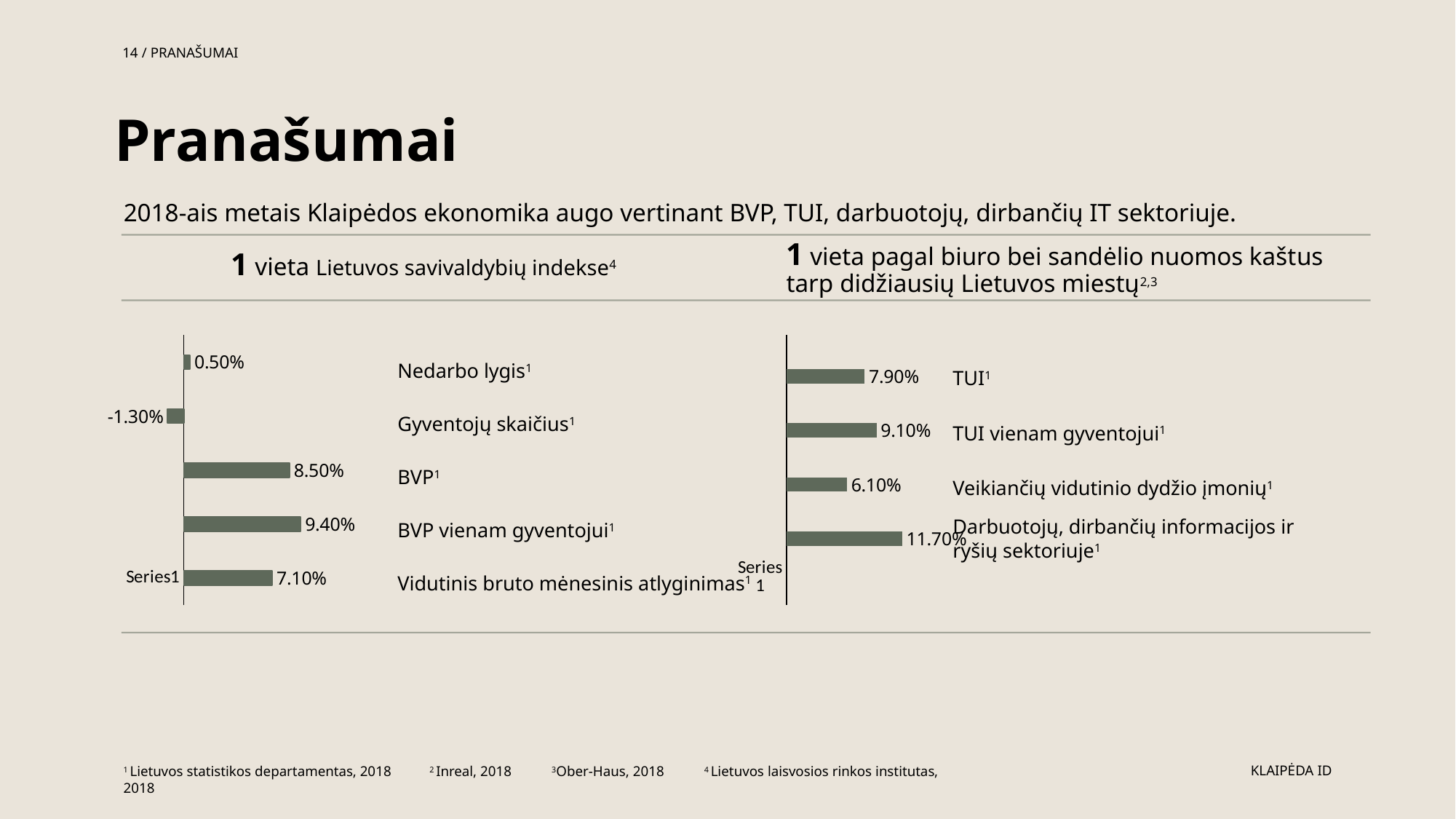
In the left chart, how many categories are plotted? 5 What type of chart is the right chart? Bar chart In the left chart, what is the value for Vidutinis bruto mėnesinis atlyginimas? 7.10% In the right chart, what is the value for Darbuotojų, dirbančių informacijos ir ryšių sektoriuje? 11.70% In the left chart, what is the difference between BVP vienam gyventojui and BVP? 0.90% In the left chart, what is the value for Gyventojų skaičius? -1.30% In the right chart, what is the value for TUI vienam gyventojui? 9.10% In the left chart, what is the value for BVP? 8.50% In the left chart, which category has the highest value? BVP vienam gyventojui In the right chart, which is larger, TUI or TUI vienam gyventojui? TUI vienam gyventojui In the left chart, which category has the lowest value? Gyventojų skaičius In the right chart, which category has the lowest value? Veikiančių vidutinio dydžio įmonių